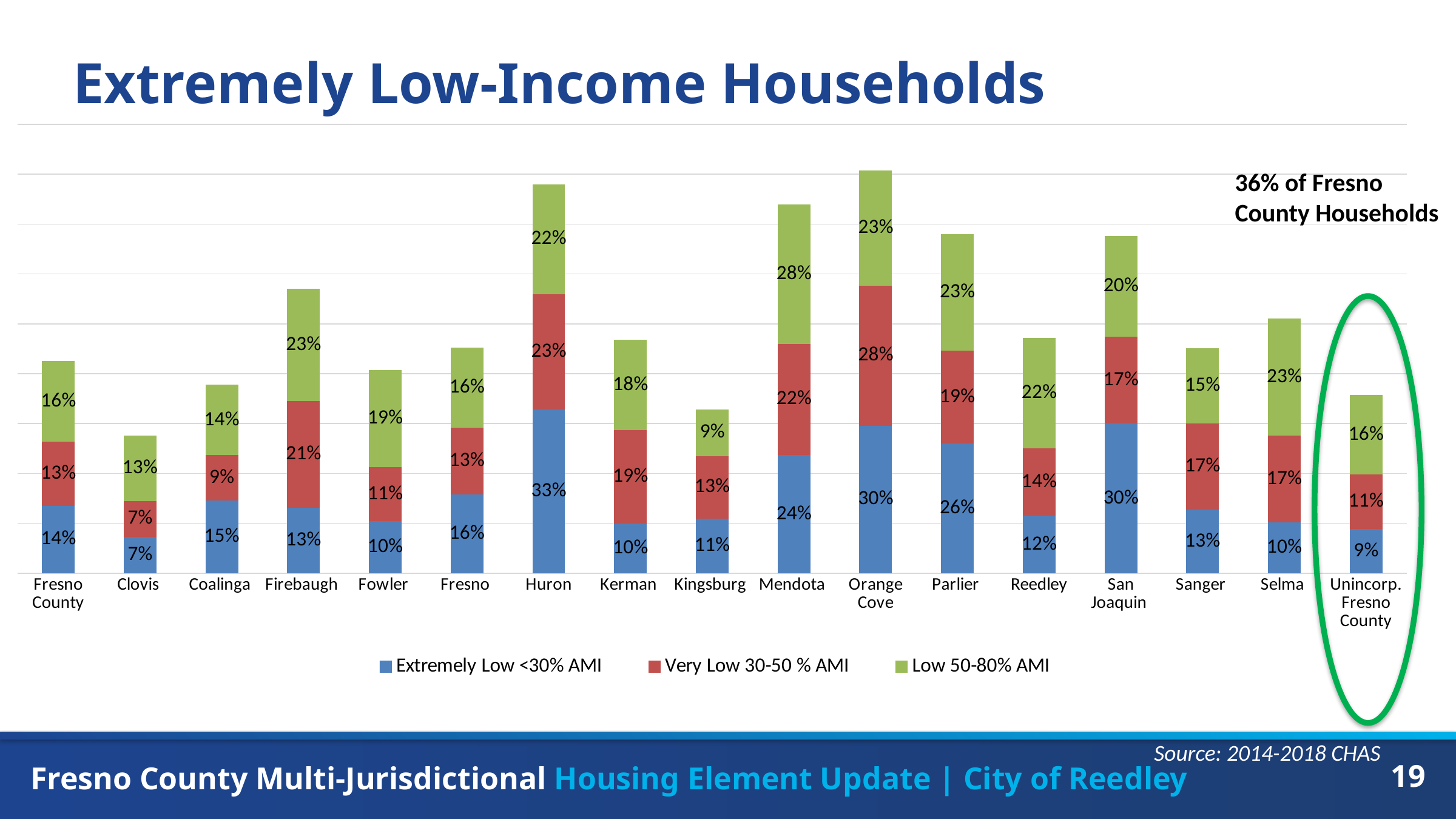
What is the difference between the Extremely Low <30% AMI values for Orange Cove and Clovis? 23% What is the total of the stacked bar for Orange Cove? 81% Which jurisdiction has the lowest Low 50-80% AMI value? Kingsburg What is the Very Low 30-50 % AMI value for Firebaugh? 21% What is the Low 50-80% AMI value for Reedley? 22% Which jurisdiction has the highest Extremely Low <30% AMI value? Huron What is the Extremely Low <30% AMI value for Huron? 33% How many jurisdictions (categories) are shown on the x axis? 17 Which has a larger Very Low 30-50 % AMI value, Mendota or Sanger? Mendota How many series does the legend list? 3 What kind of chart is shown on the slide? Stacked bar chart What is the total of the stacked bar for Unincorp. Fresno County? 36%